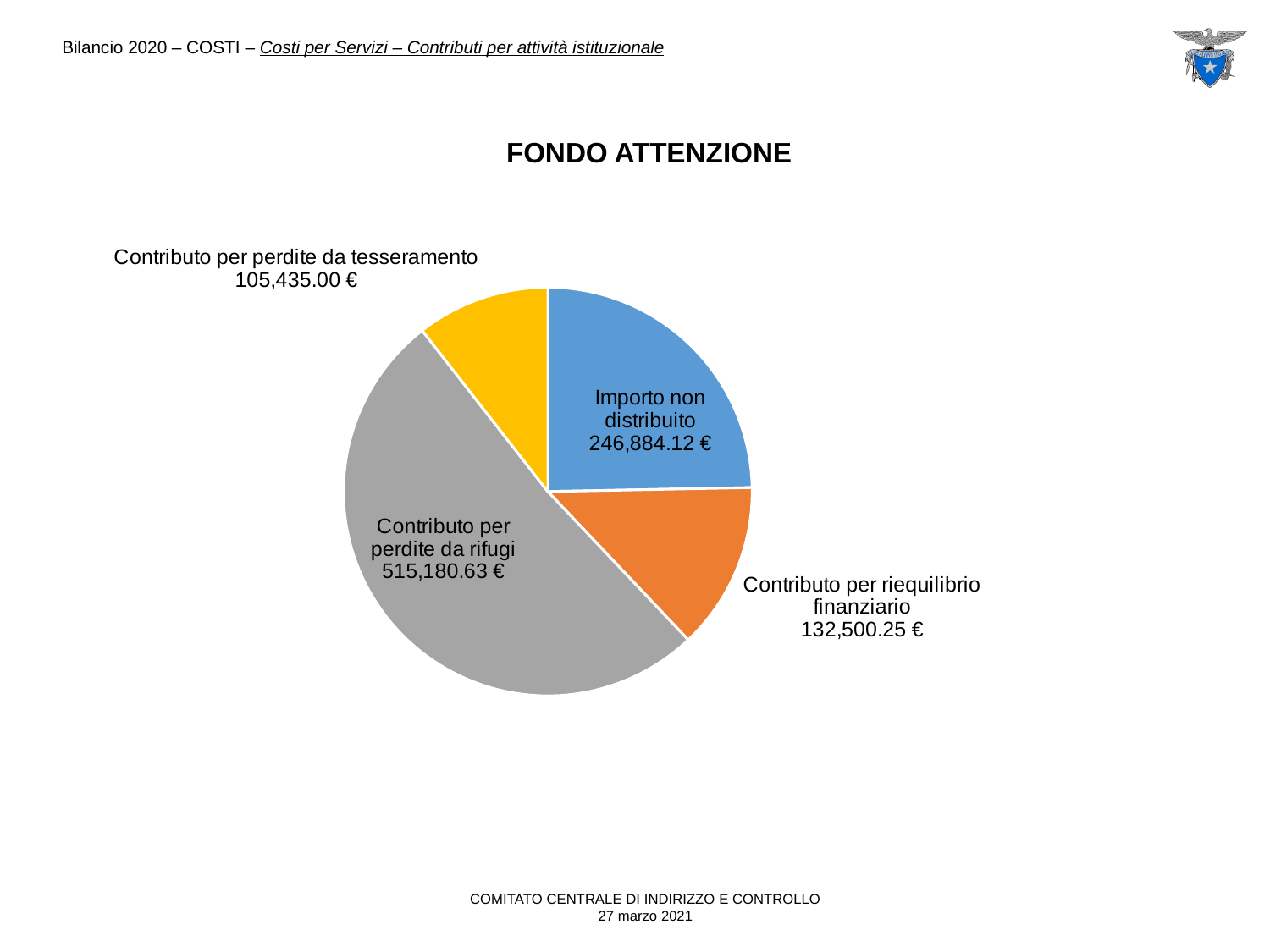
What is the title of the chart? FONDO ATTENZIONE What is the total of all slices in the pie chart? 1,000,000.00 € What is the value for Importo non distribuito? 246,884.12 € What type of chart is shown on the slide? Pie chart What is the value for Contributo per riequilibrio finanziario? 132,500.25 € Which slice has the smallest value? Contributo per perdite da tesseramento What is the value for Contributo per perdite da rifugi? 515,180.63 € Which slice has the largest value? Contributo per perdite da rifugi Which is larger, Importo non distribuito or Contributo per riequilibrio finanziario? Importo non distribuito What is the value for Contributo per perdite da tesseramento? 105,435.00 € What is the difference between Contributo per perdite da rifugi and Importo non distribuito? 268,296.51 € How many slices does the pie chart have? 4